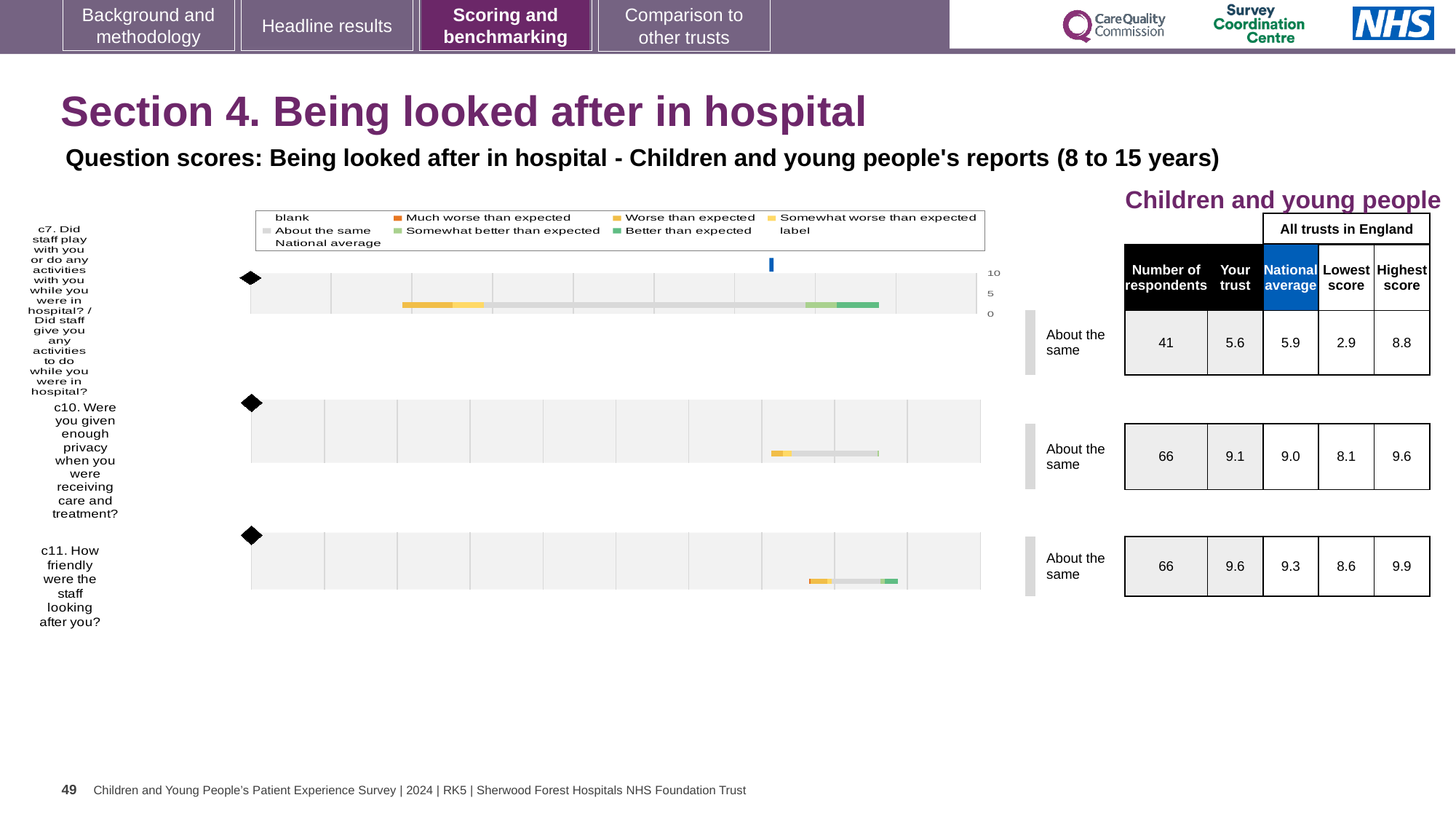
What kind of chart is used to show the question scores on this slide? Bar chart How many respondents answered question c7 (Did staff play with you or do any activities with you while you were in hospital?)? 41 How many questions are charted on this slide? 3 What is the lowest score among all trusts in England for question c10? 8.1 For question c11, how much higher is the 'Your trust' score than the national average? 0.3 What is the national average score for question c11 (How friendly were the staff looking after you?)? 9.3 Which question has the highest 'Your trust' score? c11. How friendly were the staff looking after you? Which question has the lowest 'Your trust' score? c7. Did staff play with you or do any activities with you while you were in hospital? What is the 'Your trust' score for question c10 (Were you given enough privacy when you were receiving care and treatment?)? 9.1 For question c7, what is the difference between the highest score and the lowest score among all trusts in England? 5.9 What benchmark category is shown for question c10? About the same For question c7, which is larger: the 'Your trust' score or the national average? National average